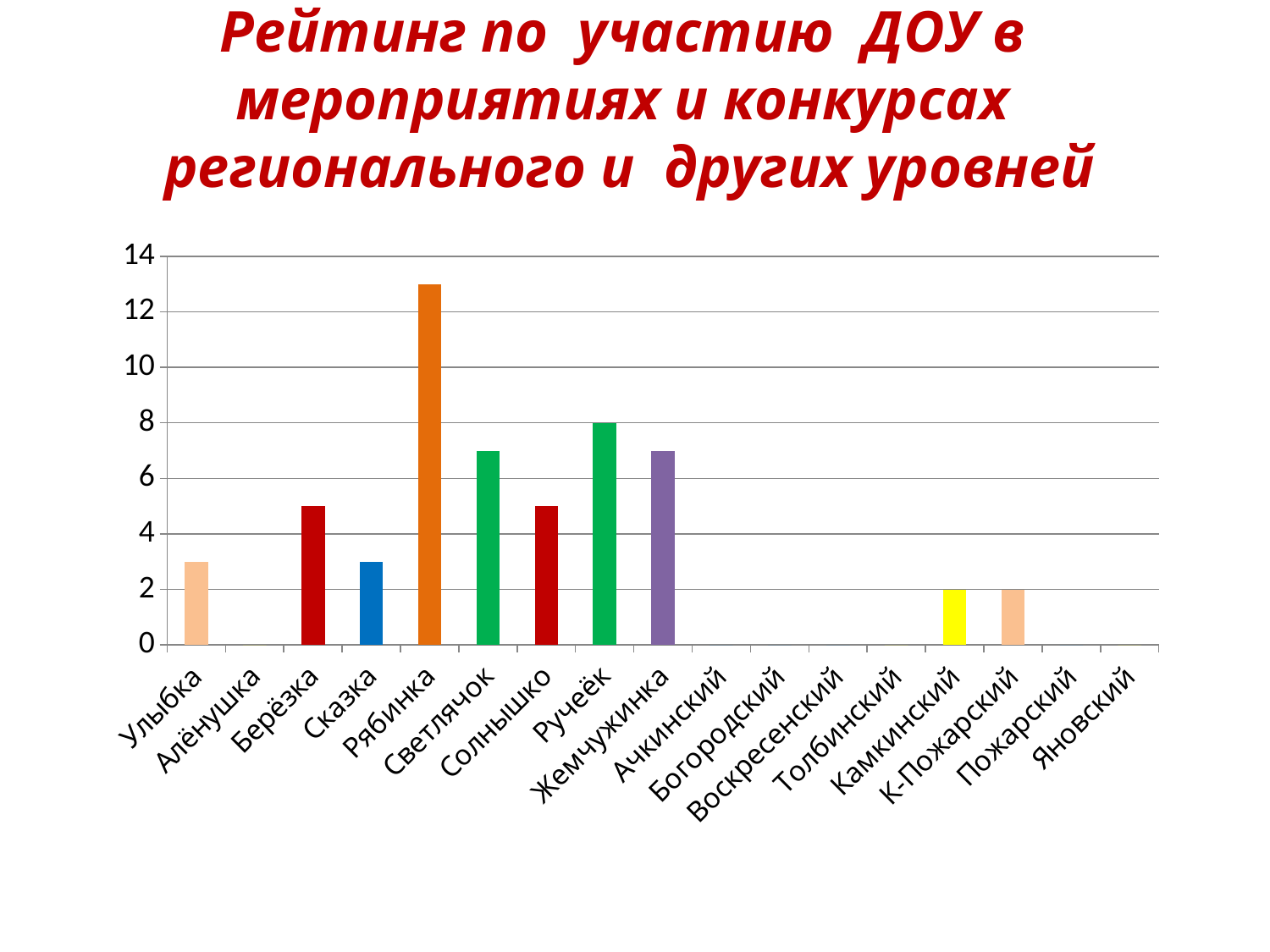
What is the value for Камкинский? 2 Which is larger, the value for Рябинка or the value for Ручеёк? Рябинка Which category has the highest bar? Рябинка What is the value for Богородский? 0 What is the value for Ручеёк? 8 Is the value for Светлячок greater or less than 8? less Is the value for Берёзка greater or less than 4? greater How many categories are shown on the x axis? 17 Is the value for Рябинка greater or less than 12? greater Which is larger, the value for Берёзка or the value for Сказка? Берёзка What kind of chart is shown on the slide? bar chart What is the value for К-Пожарский? 2